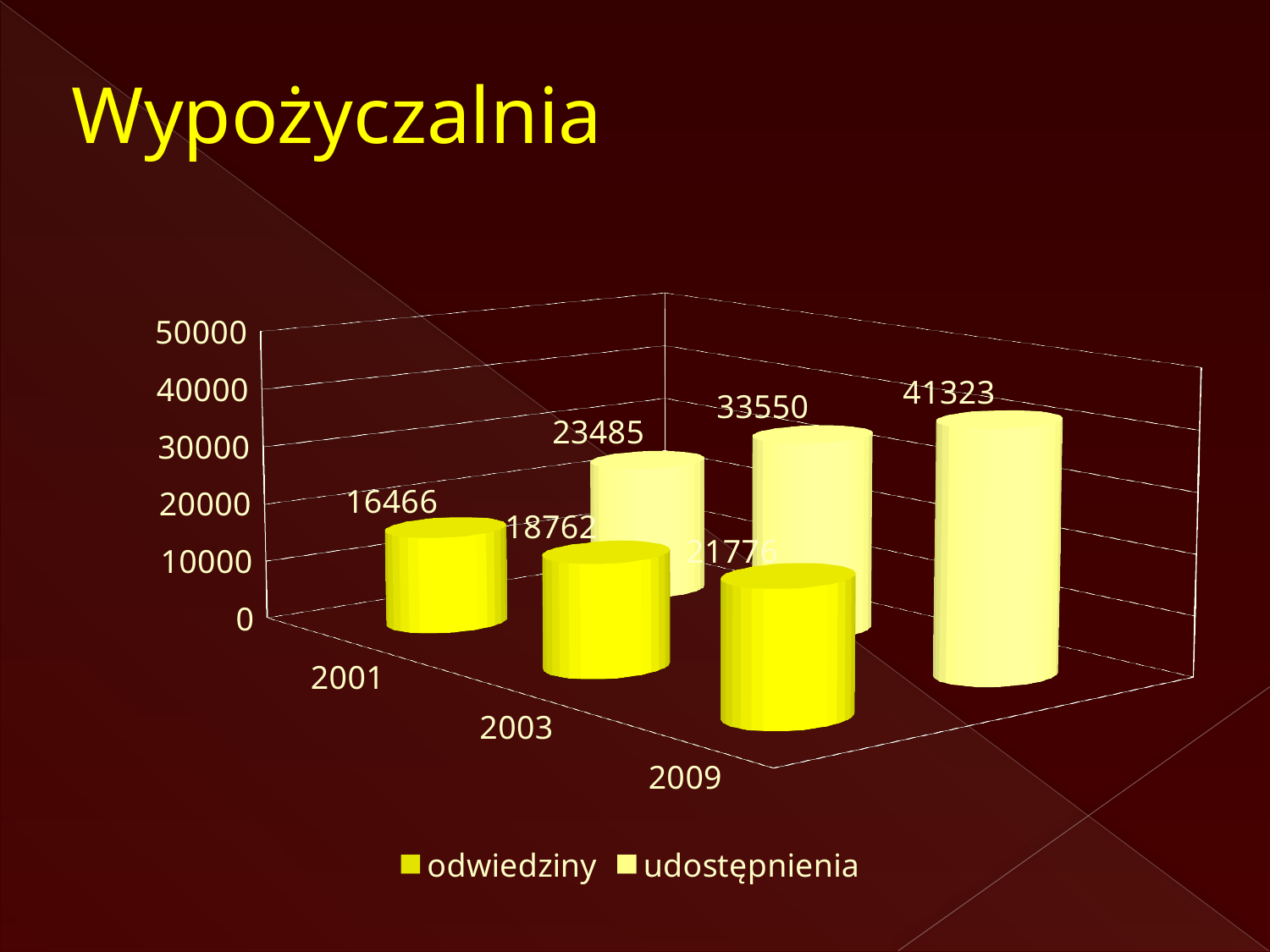
How many years are shown on the x axis? 3 In which year is udostępnienia highest? 2009 What kind of chart is shown on the slide? bar chart In which year is odwiedziny lowest? 2001 What is the value for odwiedziny in 2009? 21776 What is the value for udostępnienia in 2009? 41323 How many series does the legend list? 2 What is the value for odwiedziny in 2001? 16466 Which is larger in 2001: odwiedziny or udostępnienia? udostępnienia Do the udostępnienia values rise or fall from 2001 to 2009? rise What is the difference between udostępnienia and odwiedziny in 2003? 14788 What is the value for udostępnienia in 2003? 33550